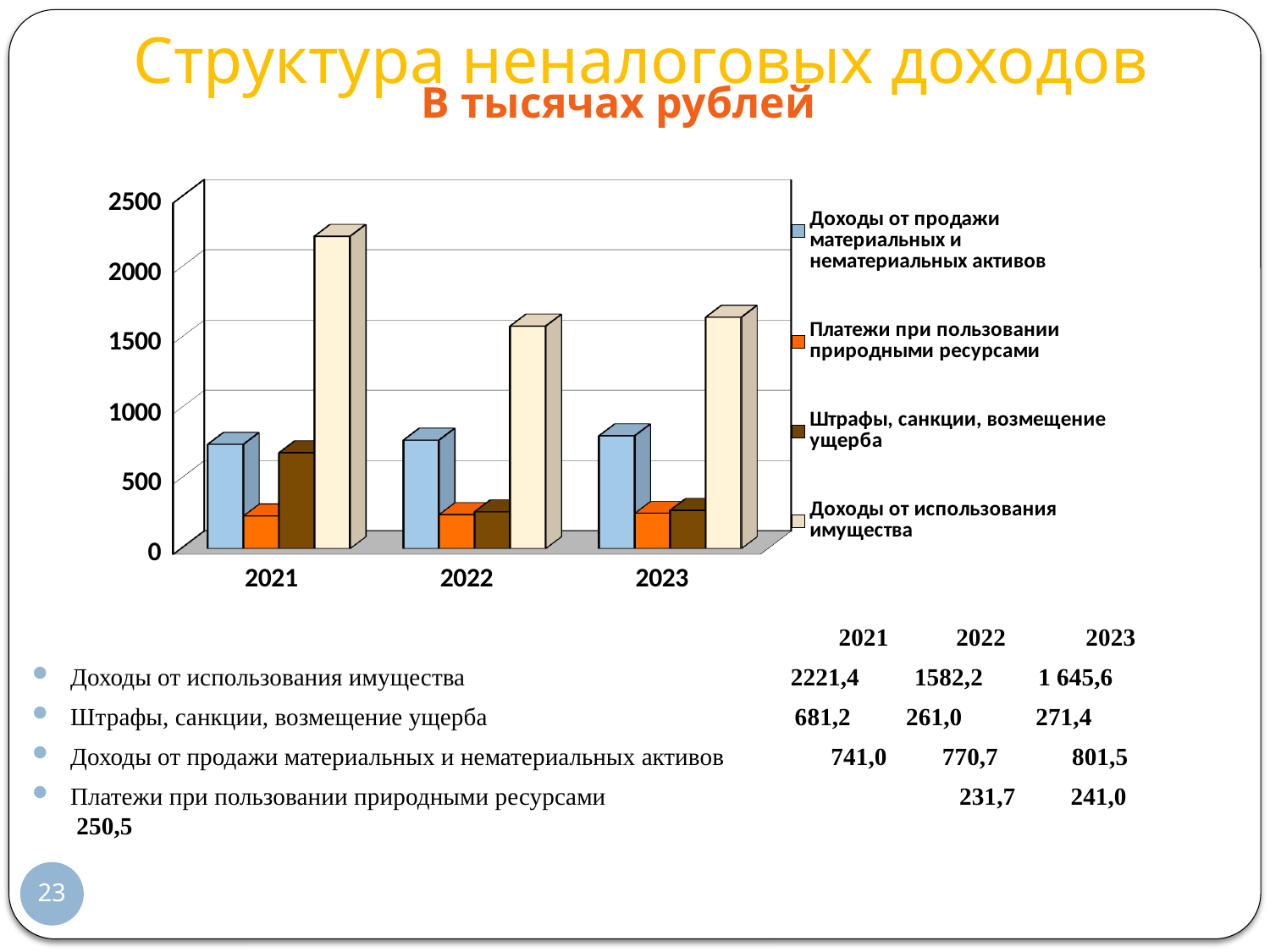
How many series does the chart legend list? 4 What is the difference between Доходы от использования имущества in 2021 and in 2022? 639,2 Which is larger in 2023: Доходы от продажи материальных и нематериальных активов or Штрафы, санкции, возмещение ущерба? Доходы от продажи материальных и нематериальных активов In which year is Доходы от использования имущества highest? 2021 In which year is Штрафы, санкции, возмещение ущерба lowest? 2022 How many years are shown on the x axis of the chart? 3 Do the values for Доходы от продажи материальных и нематериальных активов rise or fall from 2021 to 2023? rise What is the value of Штрафы, санкции, возмещение ущерба for 2022? 261,0 What kind of chart is shown on the slide? bar chart Is the value for Доходы от использования имущества in 2021 greater or less than 2000? greater What is the value of Доходы от использования имущества for 2021? 2221,4 What is the value of Доходы от продажи материальных и нематериальных активов for 2023? 801,5